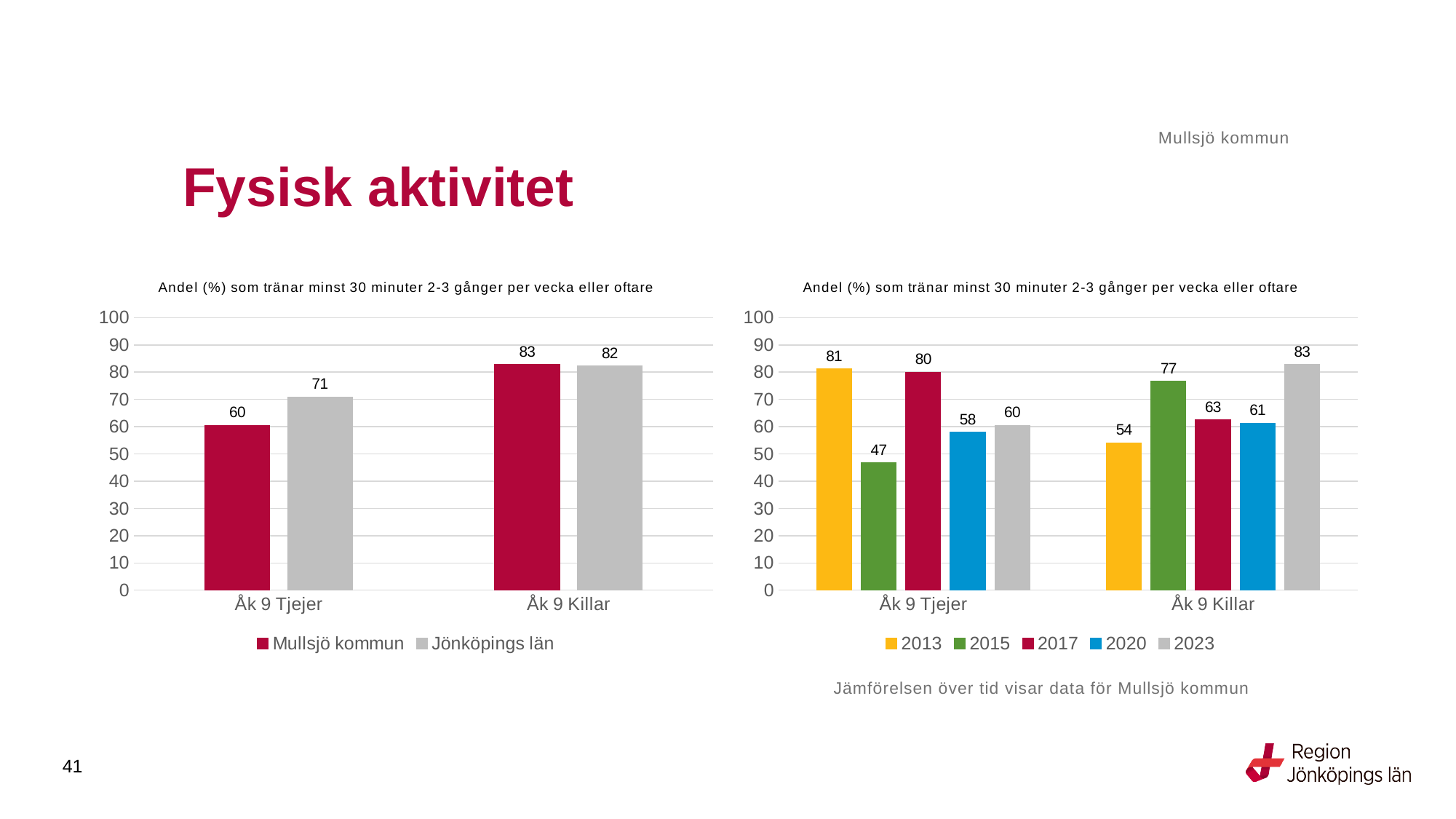
In the left chart, what is the value for Jönköpings län for Åk 9 Killar? 82 In the right chart, which is larger for Åk 9 Killar: 2013 or 2015? 2015 In the left chart, how many series does the legend list? 2 In the right chart, which year has the lowest value for Åk 9 Tjejer? 2015 In the left chart, what is the difference between Jönköpings län and Mullsjö kommun for Åk 9 Tjejer? 11 In the right chart, what is the value for 2015 for Åk 9 Tjejer? 47 What kind of chart is the left chart? Bar chart In the right chart, how many series does the legend list? 5 In the left chart, what is the value for Mullsjö kommun for Åk 9 Tjejer? 60 In the right chart, what is the difference between 2023 and 2013 for Åk 9 Killar? 29 In the right chart, what is the value for 2023 for Åk 9 Killar? 83 In the right chart, which year has the highest value for Åk 9 Killar? 2023